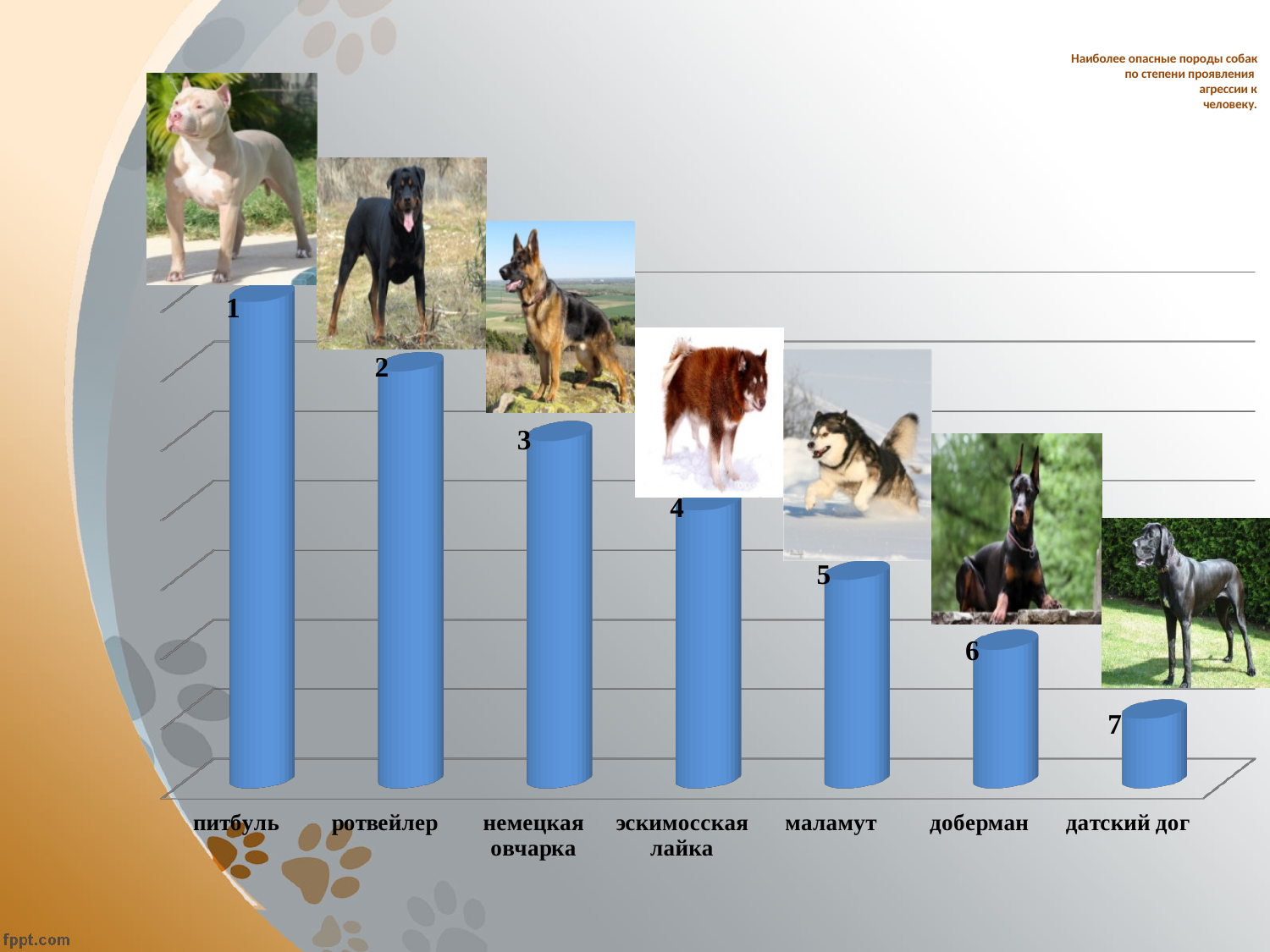
What number is printed on the bar for маламут? 5 What number is printed on the bar for датский дог? 7 Which bar is taller, ротвейлер or доберман? ротвейлер Do the bar heights rise or fall from left to right across the chart? fall How many dog breeds (categories) are shown on the chart? 7 What kind of chart is shown on the slide? bar chart Which bar is taller, маламут or немецкая овчарка? немецкая овчарка What number is printed on the bar for эскимосская лайка? 4 Which breed has the tallest bar on the chart? питбуль Which breed is labelled with the number 2 on the chart? ротвейлер What is the title of the chart on the slide? Наиболее опасные породы собак по степени проявления агрессии к человеку. Which breed has the shortest bar on the chart? датский дог